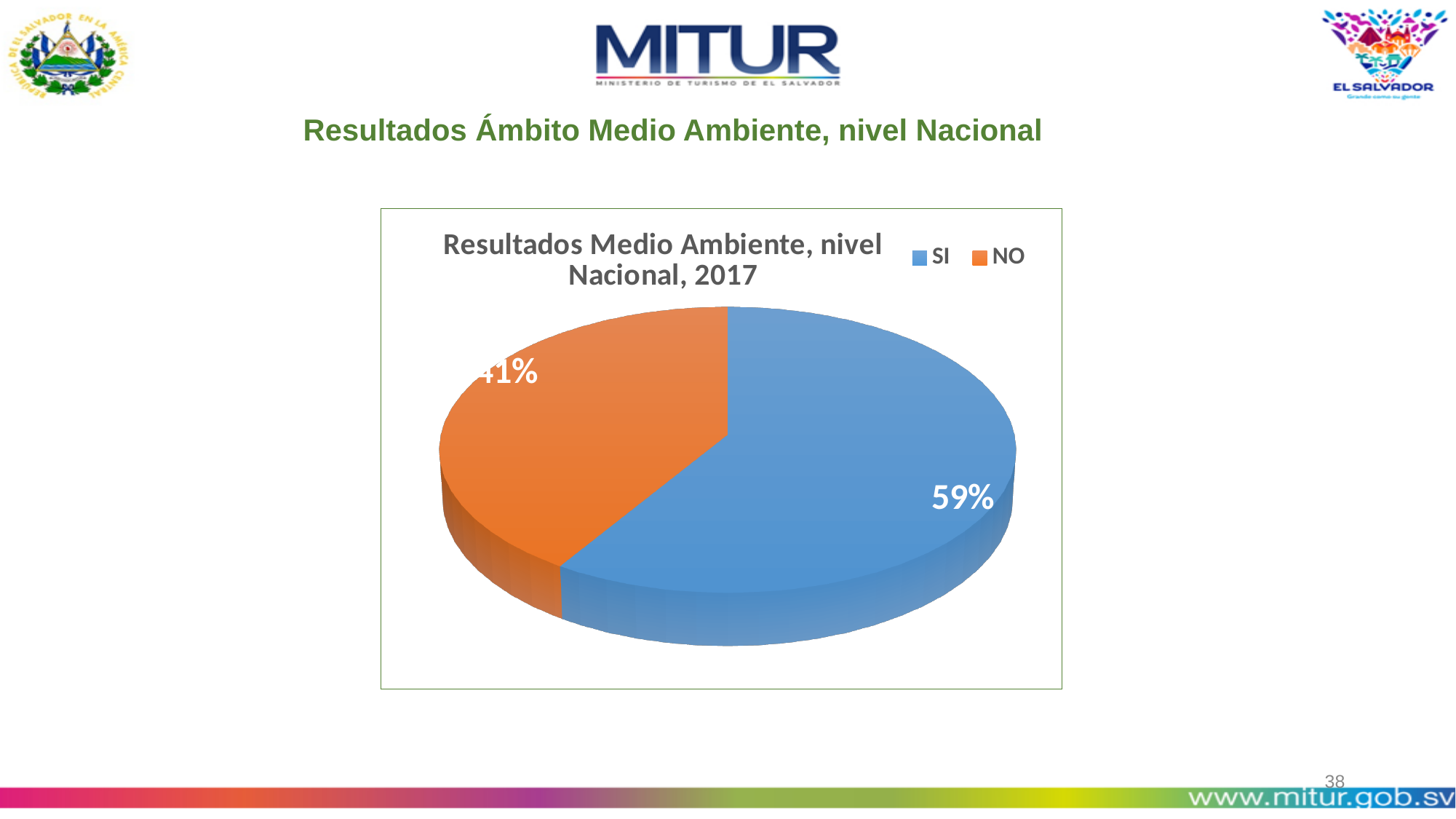
What colour is the SI slice in the pie chart? blue What type of chart is shown on the slide? pie chart What percentage of the pie corresponds to NO? 41% How many slices does the pie chart have? 2 What is the title of the chart? Resultados Medio Ambiente, nivel Nacional, 2017 How many entries does the legend list? 2 Which is larger, the SI slice or the NO slice? SI What is the difference in percentage points between the SI and NO slices? 18 Which category has the smallest share of the pie? NO What percentage of the pie corresponds to SI? 59% Which category has the largest share of the pie? SI